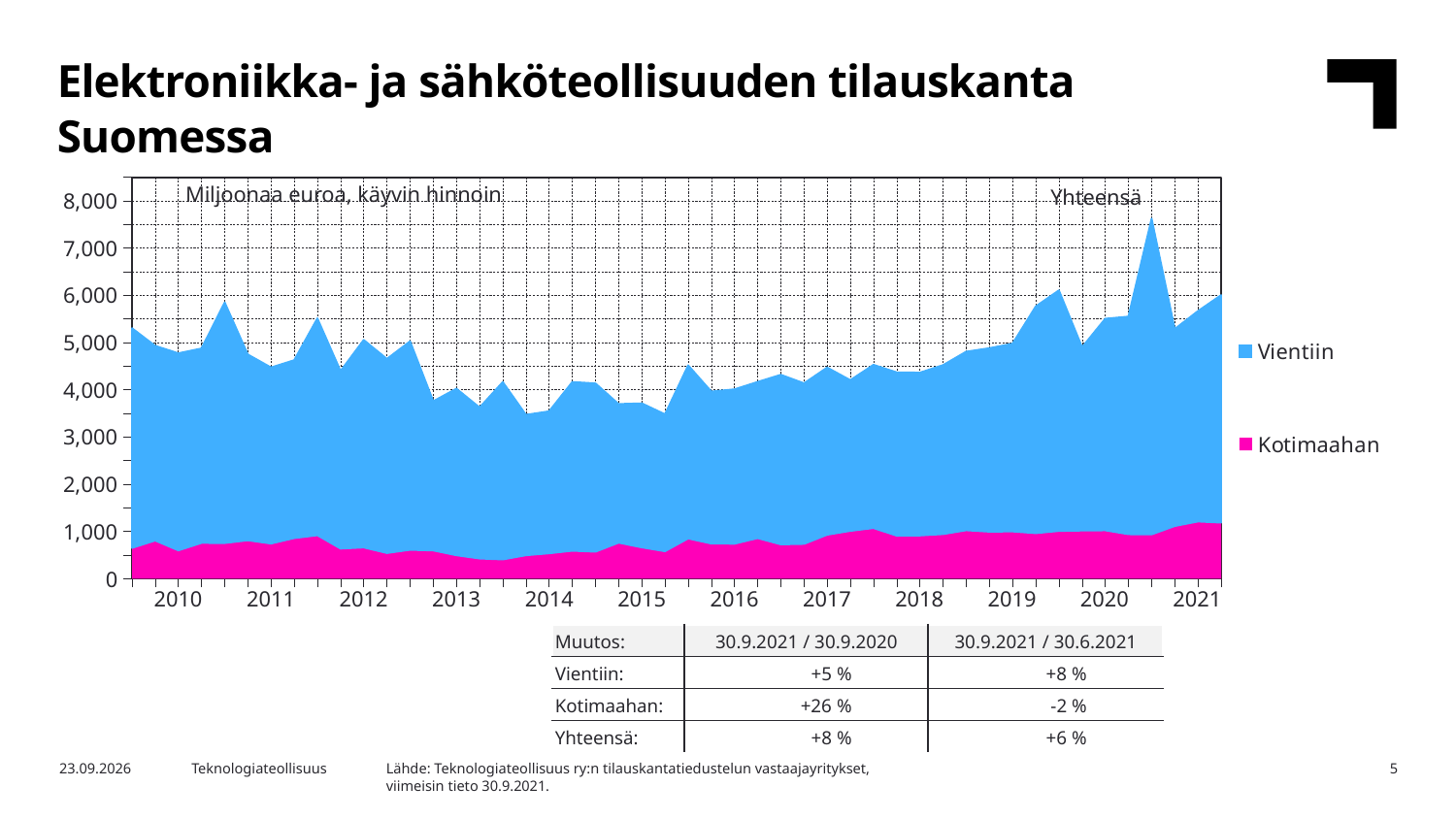
Is the highest peak of the total in 2020 greater or less than 7,000? greater Is the Kotimaahan value at the end of 2021 greater or less than 2,000? less What kind of chart is shown on the slide? Stacked area chart Which series is larger throughout the chart, Vientiin or Kotimaahan? Vientiin In which year does the total (Yhteensä) reach its highest peak? 2020 What unit is stated in the chart's subtitle text? Miljoonaa euroa, käyvin hinnoin How many years are labelled on the x axis of the chart? 12 What are the two series named in the chart legend? Vientiin and Kotimaahan Is the total value at the start of 2010 greater or less than 5,000? greater How many series does the chart legend list? 2 Does the total order book generally rise or fall from 2014 to 2021? rise Which is larger, the total peak in 2020 or the total peak in 2010? 2020